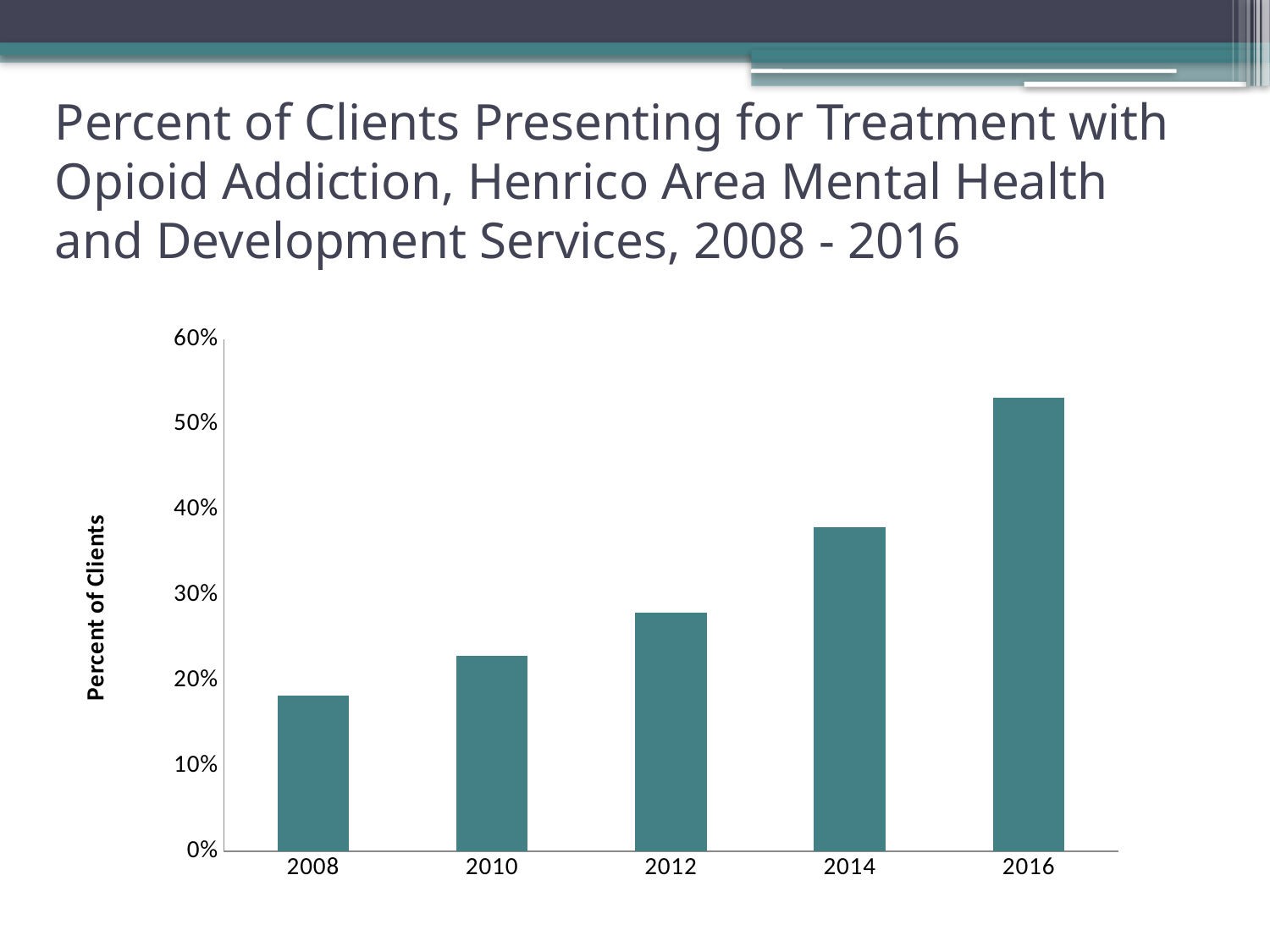
Which year has the highest percent of clients presenting with opioid addiction? 2016 How many years are plotted on the x axis of the chart? 5 Is the value for 2010 greater or less than 20%? greater Which year has a larger value, 2012 or 2014? 2014 What is the label on the vertical axis of the chart? Percent of Clients Is the value for 2008 greater or less than 20%? less Do the values rise or fall from 2008 to 2016? rise Which year has the lowest percent of clients presenting with opioid addiction? 2008 Is the value for 2014 greater or less than 30%? greater What kind of chart is shown on the slide? bar chart